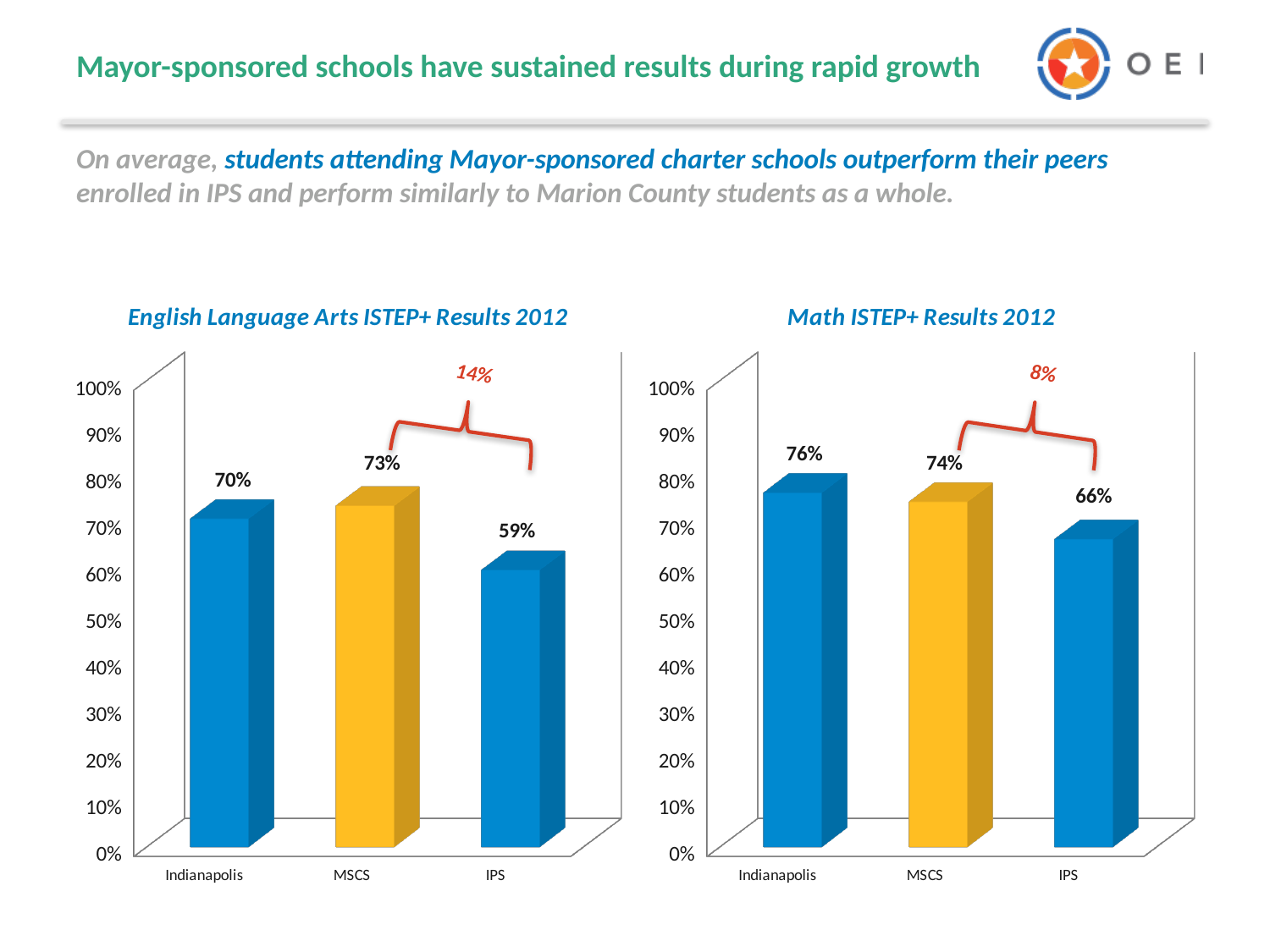
In the Math ISTEP+ Results 2012 chart, what is the value for IPS? 66% In the Math ISTEP+ Results 2012 chart, what is the difference between the Indianapolis value and the MSCS value? 2% What kind of chart is the English Language Arts ISTEP+ Results 2012 chart? Bar chart In the English Language Arts ISTEP+ Results 2012 chart, is the value for IPS greater or less than 60%? less In the English Language Arts ISTEP+ Results 2012 chart, what colour is the MSCS bar? Yellow In the English Language Arts ISTEP+ Results 2012 chart, what is the value for MSCS? 73% In the Math ISTEP+ Results 2012 chart, what is the value for Indianapolis? 76% How many categories are shown in the Math ISTEP+ Results 2012 chart? 3 In the Math ISTEP+ Results 2012 chart, which is larger, the value for Indianapolis or the value for MSCS? Indianapolis In the English Language Arts ISTEP+ Results 2012 chart, what is the difference between the MSCS value and the IPS value? 14% In the English Language Arts ISTEP+ Results 2012 chart, which category has the highest value? MSCS In the Math ISTEP+ Results 2012 chart, which category has the lowest value? IPS